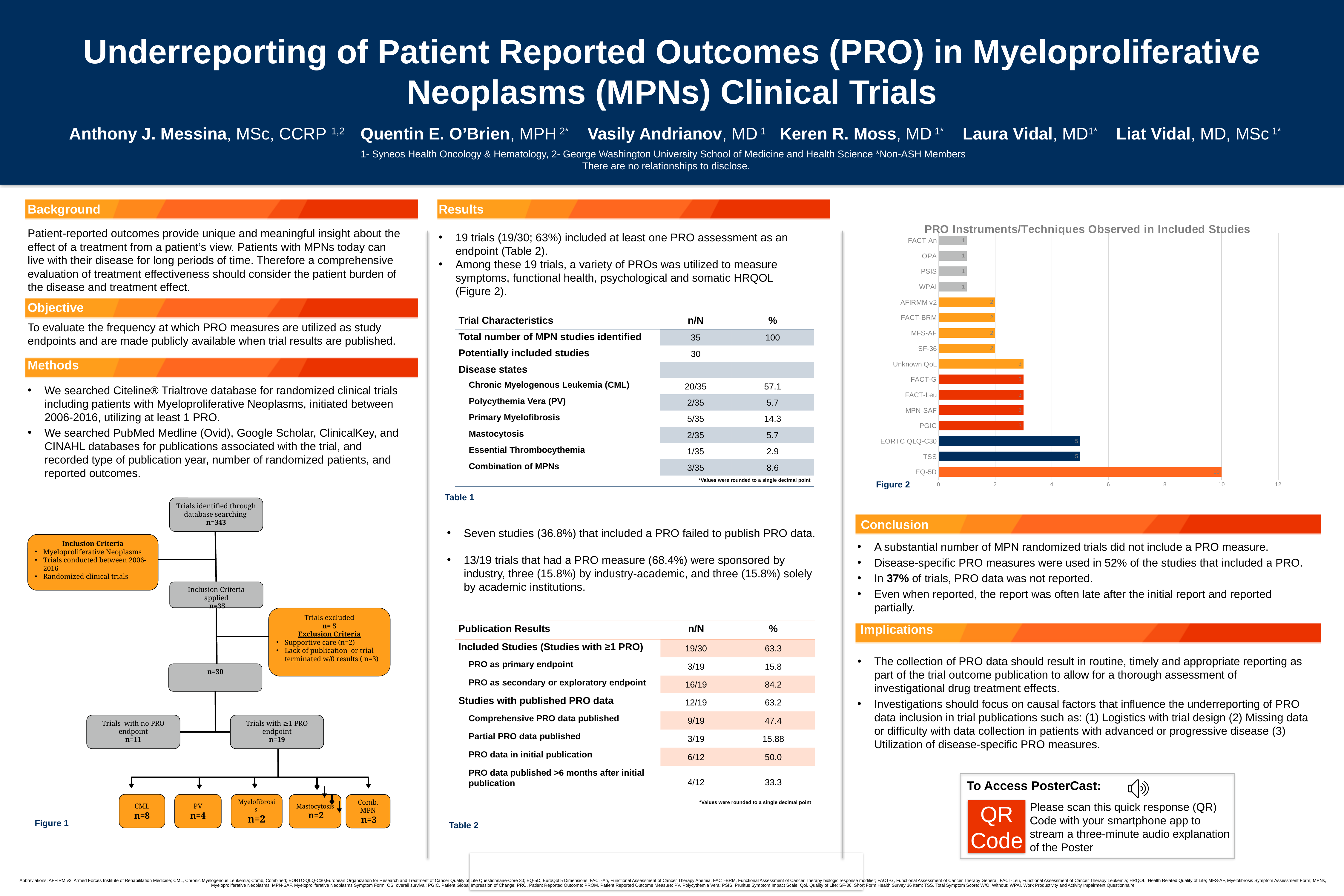
In the PRO Instruments chart, what is the value for MPN-SAF? 3 How many instruments/techniques are listed in the PRO Instruments chart? 16 What type of chart is shown under the title "PRO Instruments/Techniques Observed in Included Studies"? bar chart What is the title of the bar chart on the slide? PRO Instruments/Techniques Observed in Included Studies In the PRO Instruments chart, what is the value for EQ-5D? 10 In the PRO Instruments chart, what is the value for WPAI? 1 In the PRO Instruments chart, what is the value for SF-36? 2 In the PRO Instruments chart, which instrument has the highest value? EQ-5D In the PRO Instruments chart, what is the value for EORTC QLQ-C30? 5 In the PRO Instruments chart, what is the difference between the values for EQ-5D and TSS? 5 In the PRO Instruments chart, what is the value for TSS? 5 In the PRO Instruments chart, which has a larger value, PGIC or FACT-BRM? PGIC